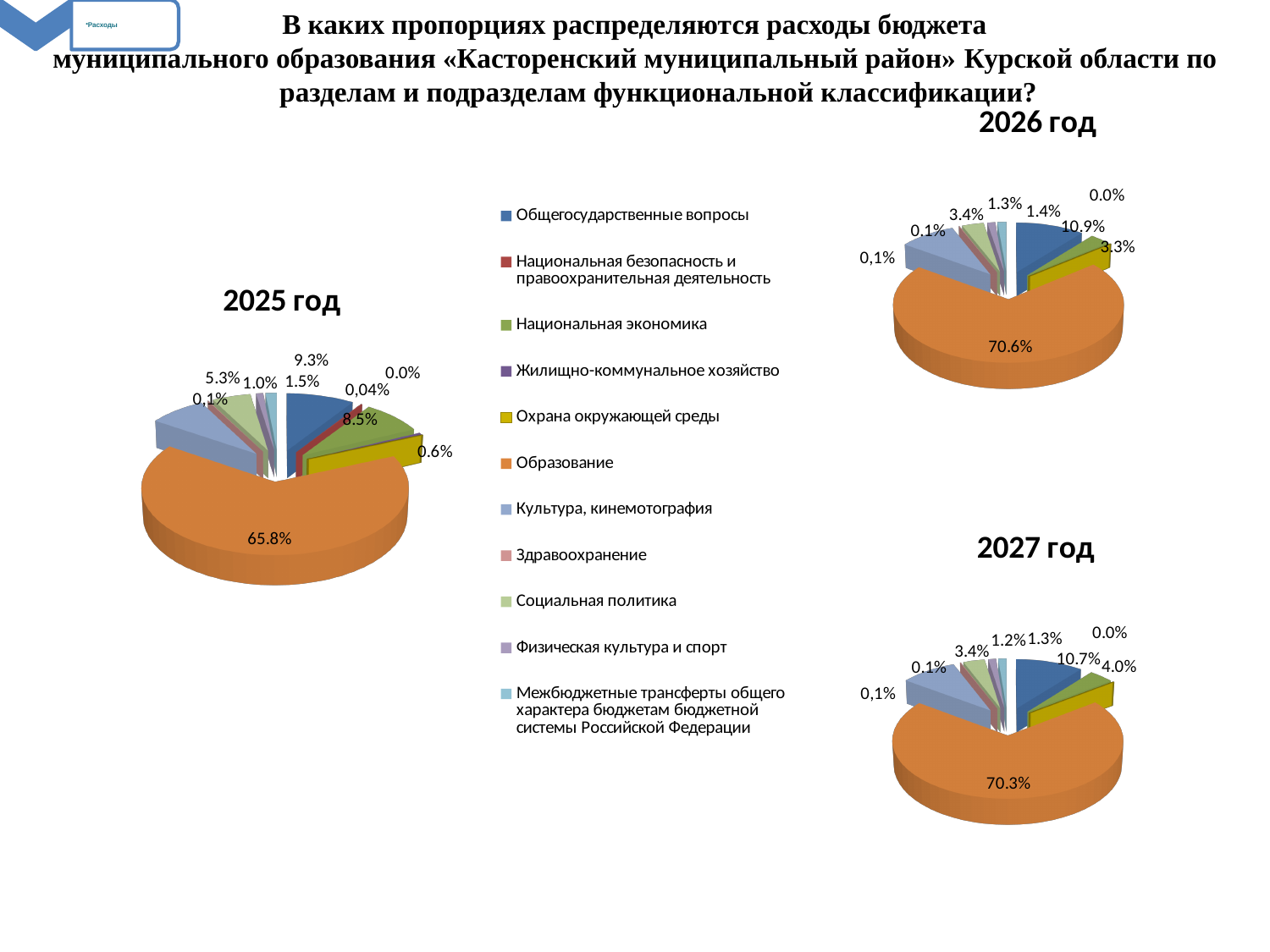
In the 2027 год chart, what is the share of Образование? 70.3% In the 2026 год chart, what is the share of the largest slice (Образование)? 70.6% How many categories does the shared legend list? 11 By how many percentage points does the share of Образование in the 2026 год chart exceed that in the 2025 год chart? 4.8 Is the share of Образование larger in the 2026 год chart or the 2027 год chart? 2026 год In the 2025 год chart, what is the share of Общегосударственные вопросы (the blue slice)? 9.3% In the 2025 год chart, which category has the largest share? Образование What kind of chart is used for the 2025 год chart? Pie chart How many pie charts are shown on the slide? 3 What is the title of the pie chart on the left side of the slide? 2025 год